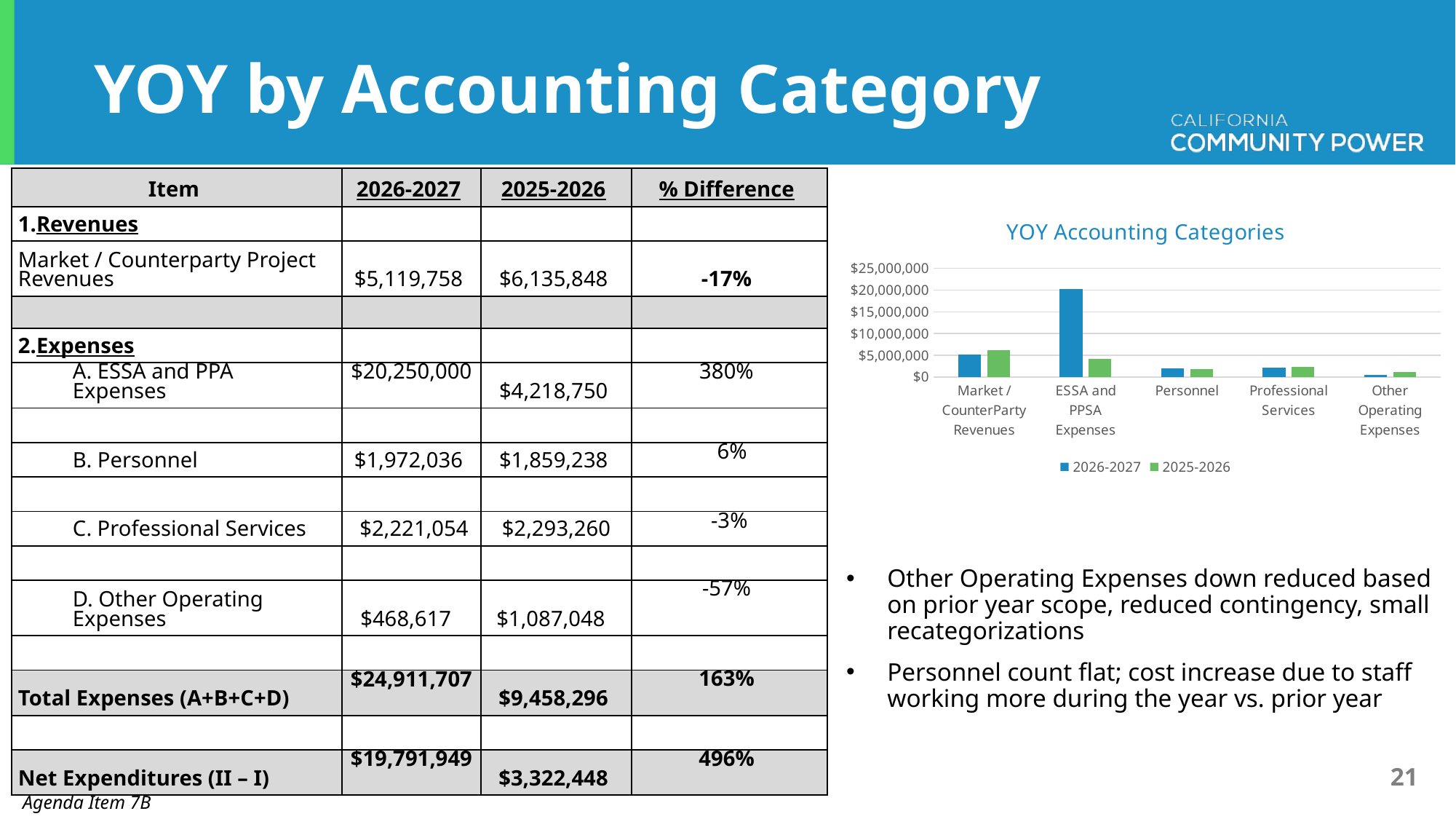
Which category has the tallest 2026-2027 bar in the chart? ESSA and PPSA Expenses What kind of chart is shown on the slide? bar chart Is the 2026-2027 value for Market / CounterParty Revenues greater or less than $10,000,000? less Which category has the shortest 2026-2027 bar in the chart? Other Operating Expenses Is the 2026-2027 value for ESSA and PPSA Expenses greater or less than $15,000,000? greater Which colour represents the 2025-2026 series in the chart? green How many series does the chart legend list? 2 For Other Operating Expenses, which series has the larger value, 2026-2027 or 2025-2026? 2025-2026 Is the 2025-2026 value for ESSA and PPSA Expenses greater or less than $5,000,000? less For ESSA and PPSA Expenses, which series has the larger value, 2026-2027 or 2025-2026? 2026-2027 How many categories are shown on the x axis of the chart? 5 What is the title of the chart? YOY Accounting Categories